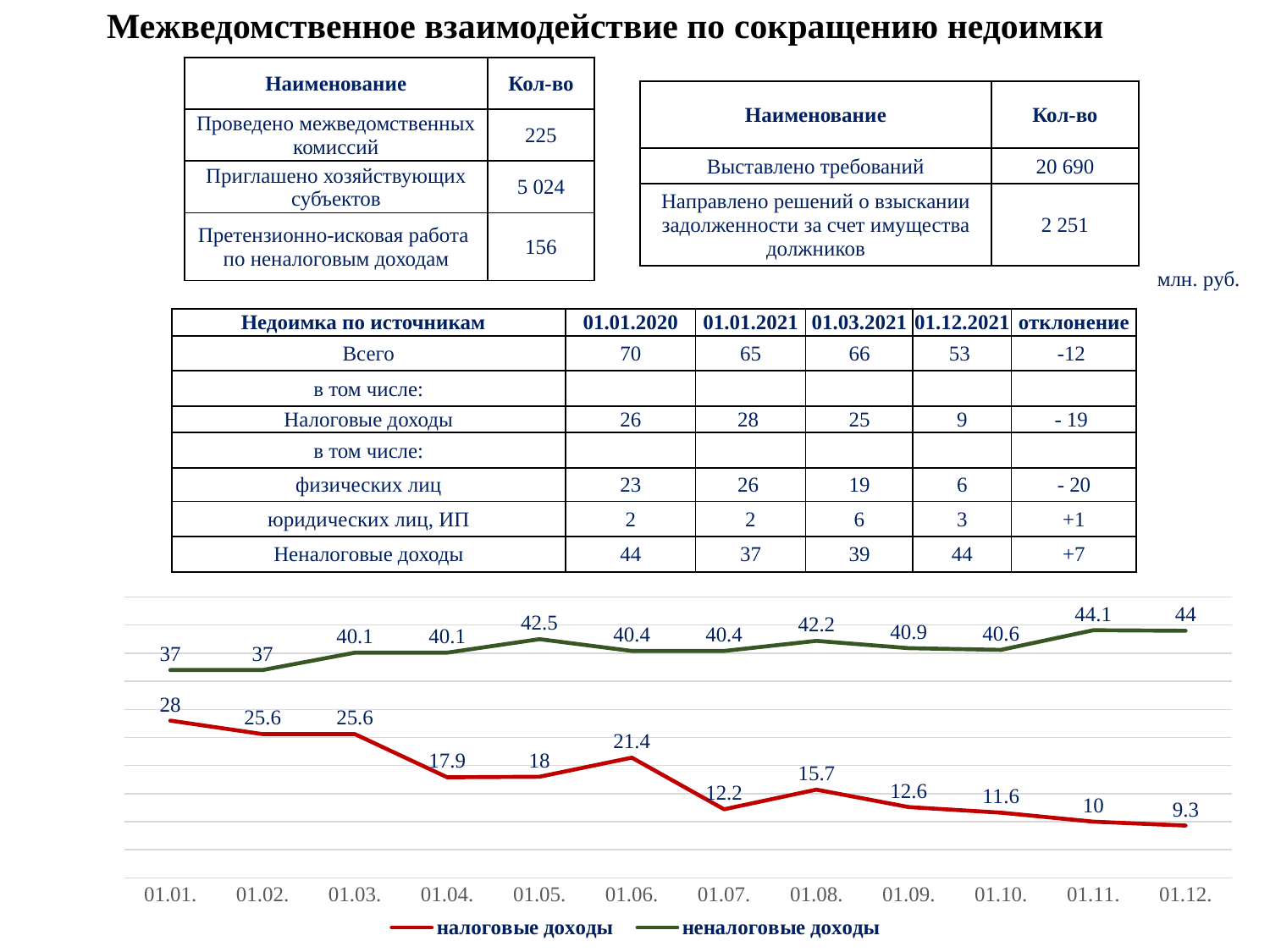
What is the value of налоговые доходы at 01.12. in the chart? 9.3 How many points are plotted along the x axis for each series in the chart? 12 Which is larger in the chart: неналоговые доходы at 01.11. or at 01.12.? 01.11. At which date does неналоговые доходы reach its lowest value in the chart? 01.01. and 01.02. Does налоговые доходы generally rise or fall from 01.01. to 01.12. in the chart? fall What is the value of неналоговые доходы at 01.05. in the chart? 42.5 At which date does налоговые доходы reach its highest value in the chart? 01.01. What is the difference between налоговые доходы at 01.01. and at 01.12. in the chart? 18.7 What is the value of налоговые доходы at 01.04. in the chart? 17.9 What type of chart is shown at the bottom of the slide? line chart How many series does the chart legend list? 2 Which colour is used for the неналоговые доходы line in the chart? green